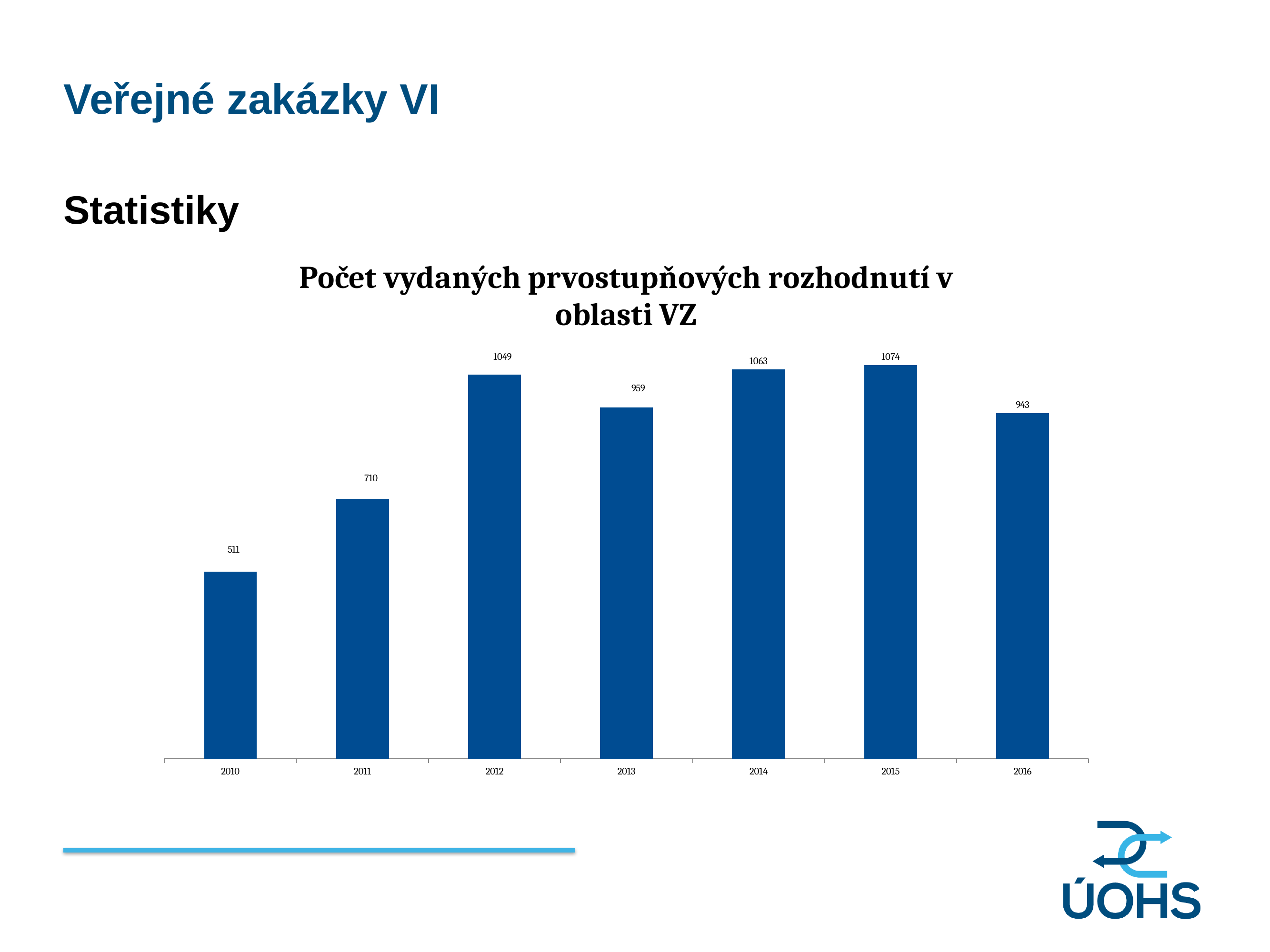
What is the difference between the values for 2011 and 2010? 199 What is the value for 2010? 511 Which year has the highest value? 2015 How many years are shown on the x axis? 7 What is the difference between the values for 2015 and 2016? 131 What is the value for 2013? 959 What kind of chart is this? bar chart What is the title of the chart? Počet vydaných prvostupňových rozhodnutí v oblasti VZ What is the value for 2016? 943 Which year has the lowest value? 2010 Which is larger, the value for 2012 or the value for 2013? 2012 Do the values rise or fall from 2010 to 2012? rise